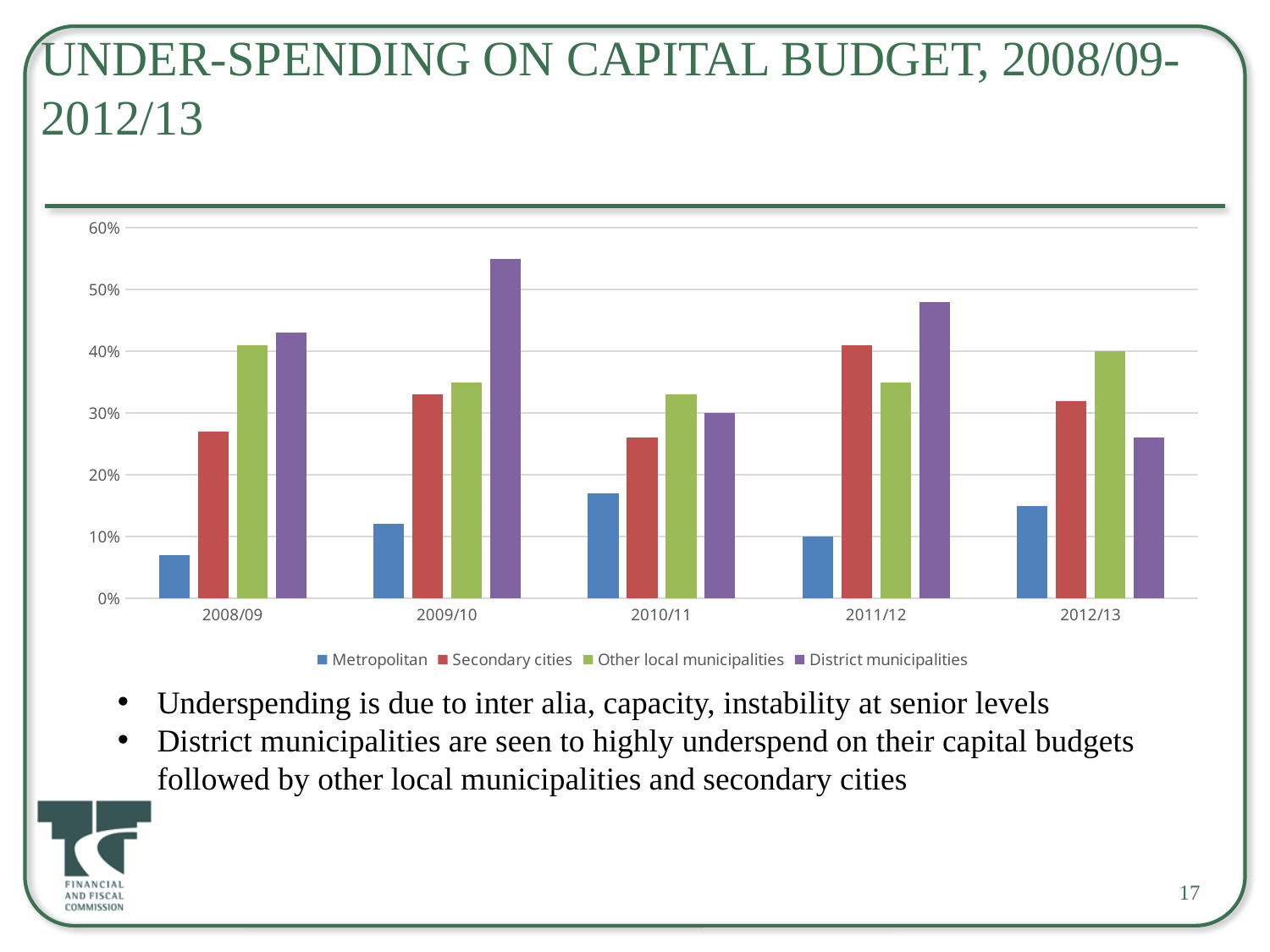
Is the value for District municipalities in 2009/10 greater or less than 50%? greater How many series does the legend list? 4 In which year is the Metropolitan bar the lowest? 2008/09 Is the value for Secondary cities in 2008/09 greater or less than 30%? less In 2011/12, which is larger: Secondary cities or Other local municipalities? Secondary cities What kind of chart is shown on the slide? bar chart Is the value for Metropolitan in 2010/11 greater or less than 20%? less How many financial years are shown on the x axis? 5 In which year is the District municipalities bar the highest? 2009/10 What colour represents District municipalities in the legend? purple Which series has the highest bar in 2012/13? Other local municipalities Which is larger for District municipalities: 2008/09 or 2012/13? 2008/09